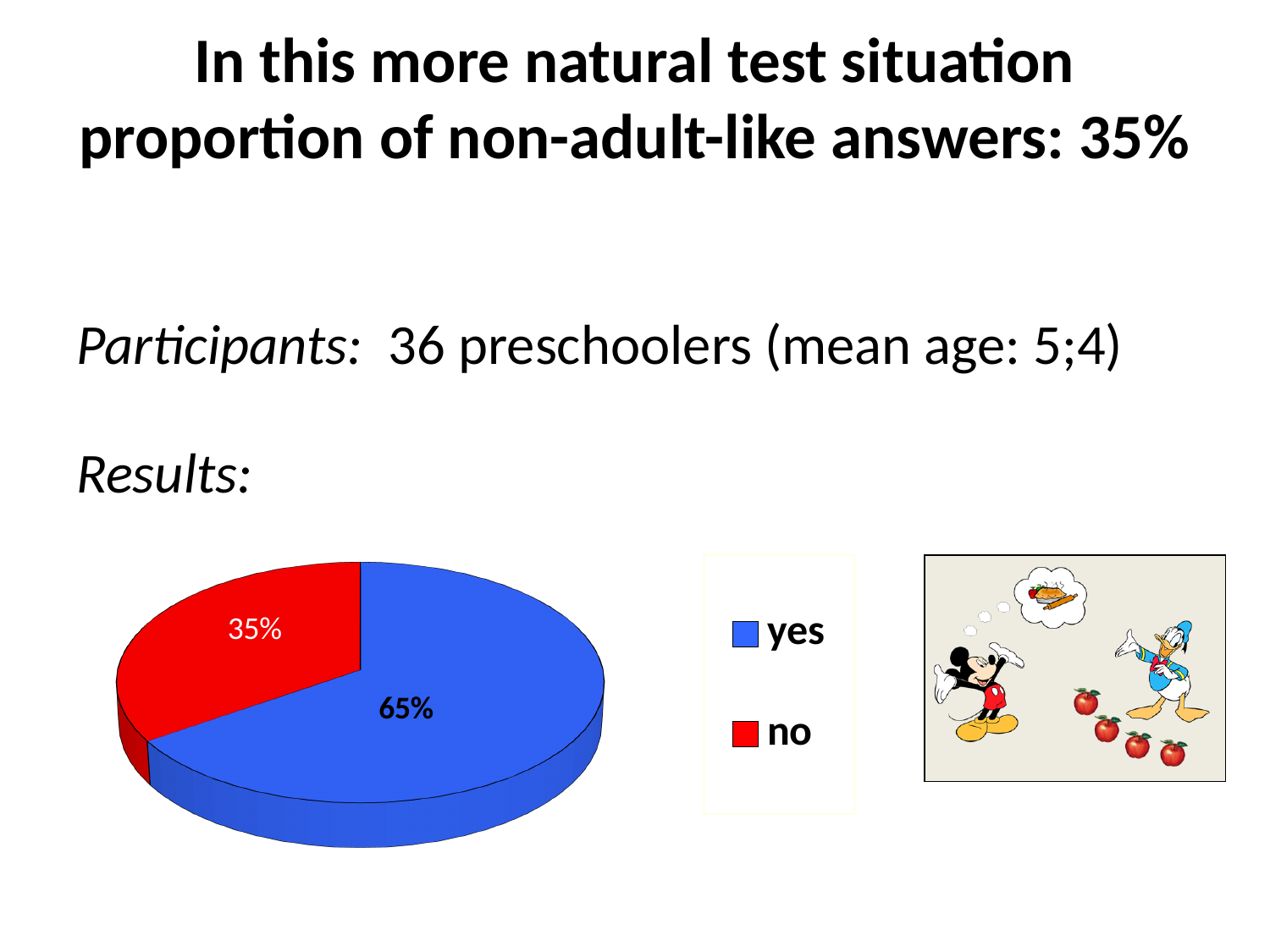
What kind of chart is shown on the slide? pie chart Which slice of the pie chart is the smallest? no What percentage of the pie chart is labelled "yes"? 65% Which slice of the pie chart is the largest? yes How many entries does the legend list? 2 What is the difference in percentage points between the "yes" and "no" slices? 30 What percentage of the pie chart is labelled "no"? 35% What colour is the "no" slice in the pie chart? red What colour is the "yes" slice in the pie chart? blue Which is larger in the pie chart, the "yes" slice or the "no" slice? yes What share of the pie does the "no" slice represent? 35% How many slices does the pie chart have? 2